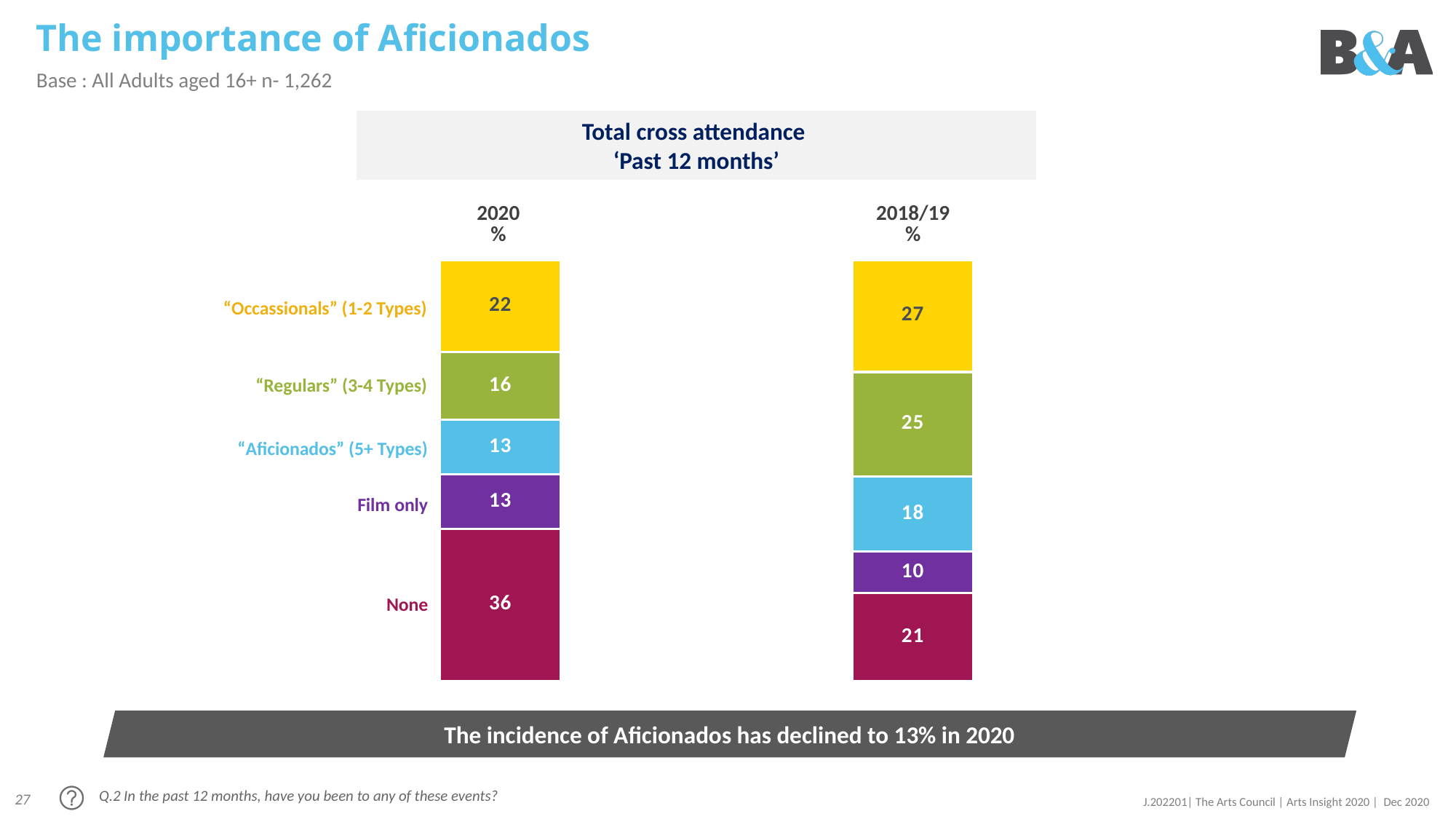
What is the difference between "Regulars" (3-4 Types) in 2018/19 and 2020? 9 How many segments make up each stacked bar? 5 What is the difference between the None values for 2020 and 2018/19? 15 What is the value for "Regulars" (3-4 Types) in the 2018/19 bar? 25 What is the title shown above the chart? Total cross attendance 'Past 12 months' Which is larger: "Occassionals" (1-2 Types) in 2020 or in 2018/19? 2018/19 What kind of chart is shown on the slide? Stacked bar chart What is the value for None in the 2020 bar? 36 What is the total of the 2018/19 stacked bar? 101 Which segment is the smallest in the 2018/19 bar? Film only Which segment is the largest in the 2020 bar? None What is the value for "Aficionados" (5+ Types) in the 2020 bar? 13